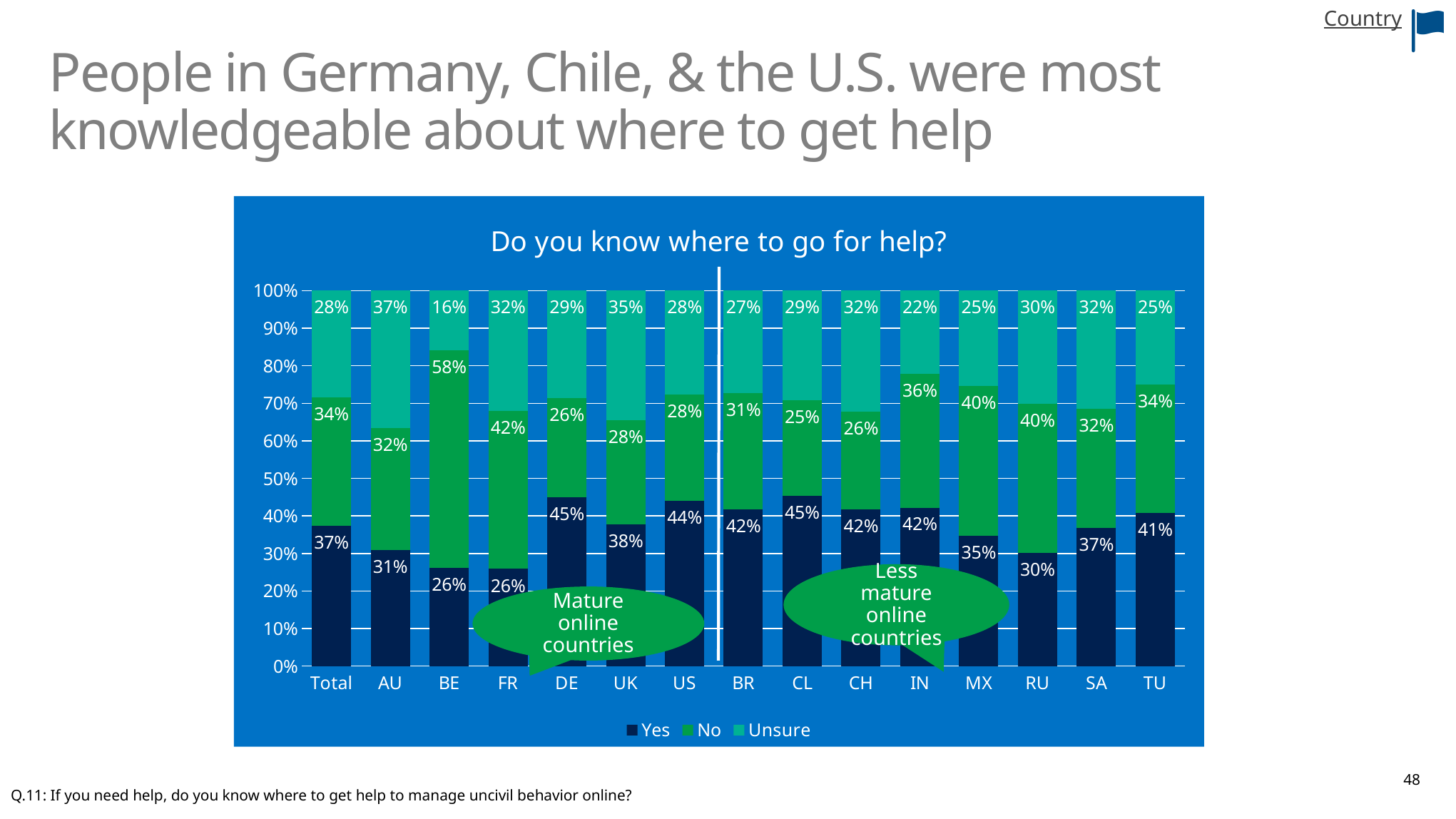
What is the "Yes" value for Germany (DE)? 45% What kind of chart is shown on the slide? Stacked bar chart What is the difference between the "Yes" values for the US and Russia (RU)? 14% What is the title of the chart? Do you know where to go for help? What is the "Unsure" value for Australia (AU)? 37% What percentage of respondents in Belgium (BE) answered "No"? 58% Which country has the highest "No" value? BE Which has a larger "No" value, Mexico (MX) or India (IN)? MX Which country has the lowest "Unsure" value? BE How many categories are shown on the x axis? 15 How many series does the legend list? 3 What is the "Yes" value for the Total bar? 37%